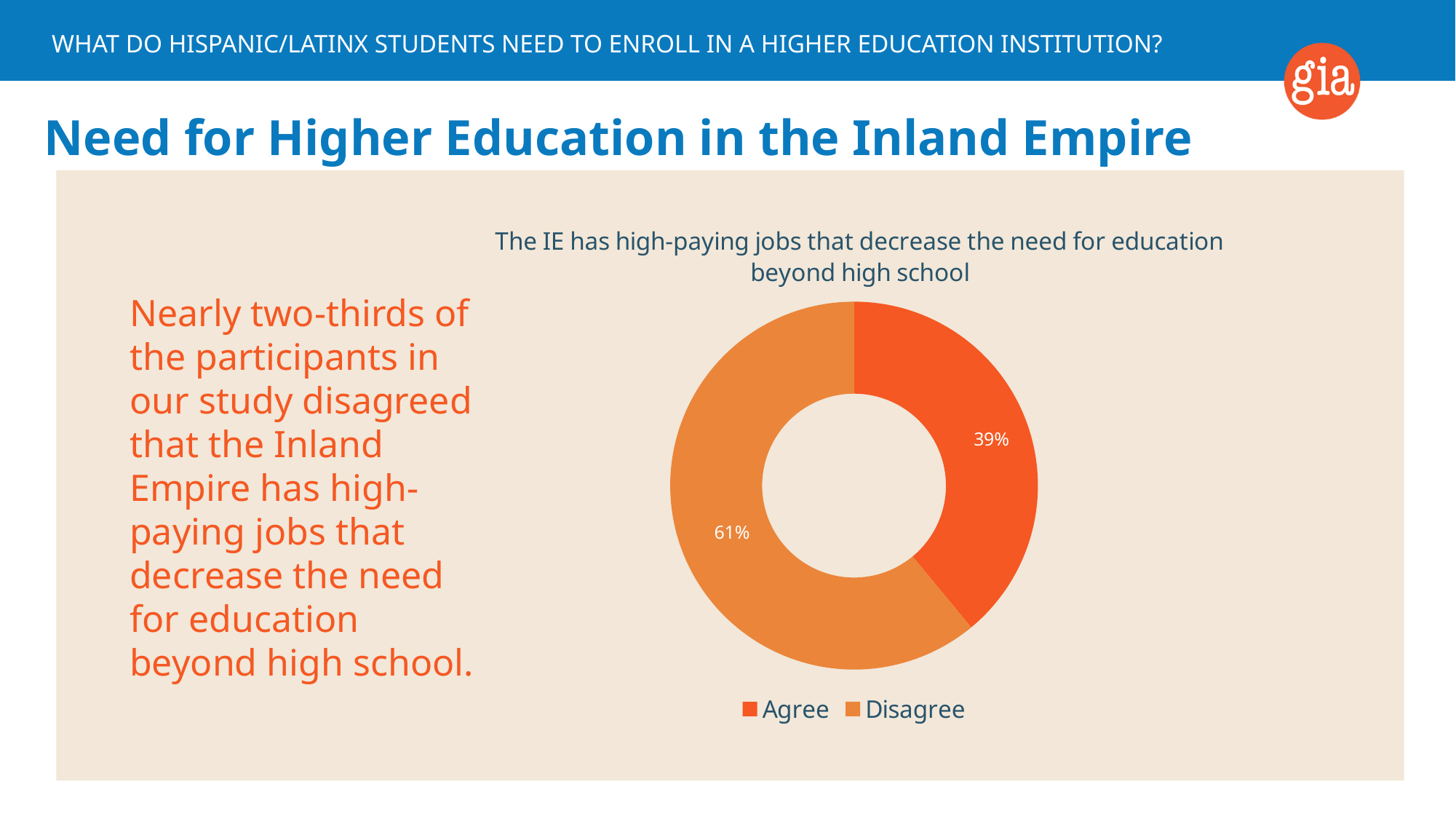
What percentage of participants disagree that the IE has high-paying jobs that decrease the need for education beyond high school? 61% What kind of chart is shown on the slide? Doughnut (pie) chart What percentage of participants agree that the IE has high-paying jobs that decrease the need for education beyond high school? 39% Which response has the smaller share of the chart? Agree What is the title of the chart? The IE has high-paying jobs that decrease the need for education beyond high school Is the share for Disagree greater or less than 50%? greater Which response has the larger share of the chart, Agree or Disagree? Disagree Which legend entry is shown in the darker red-orange colour? Agree Is the share for Agree larger or smaller than the share for Disagree? smaller What is the difference in percentage points between the Disagree and Agree shares? 22 How many entries does the chart legend list? 2 How many categories does the chart show? 2